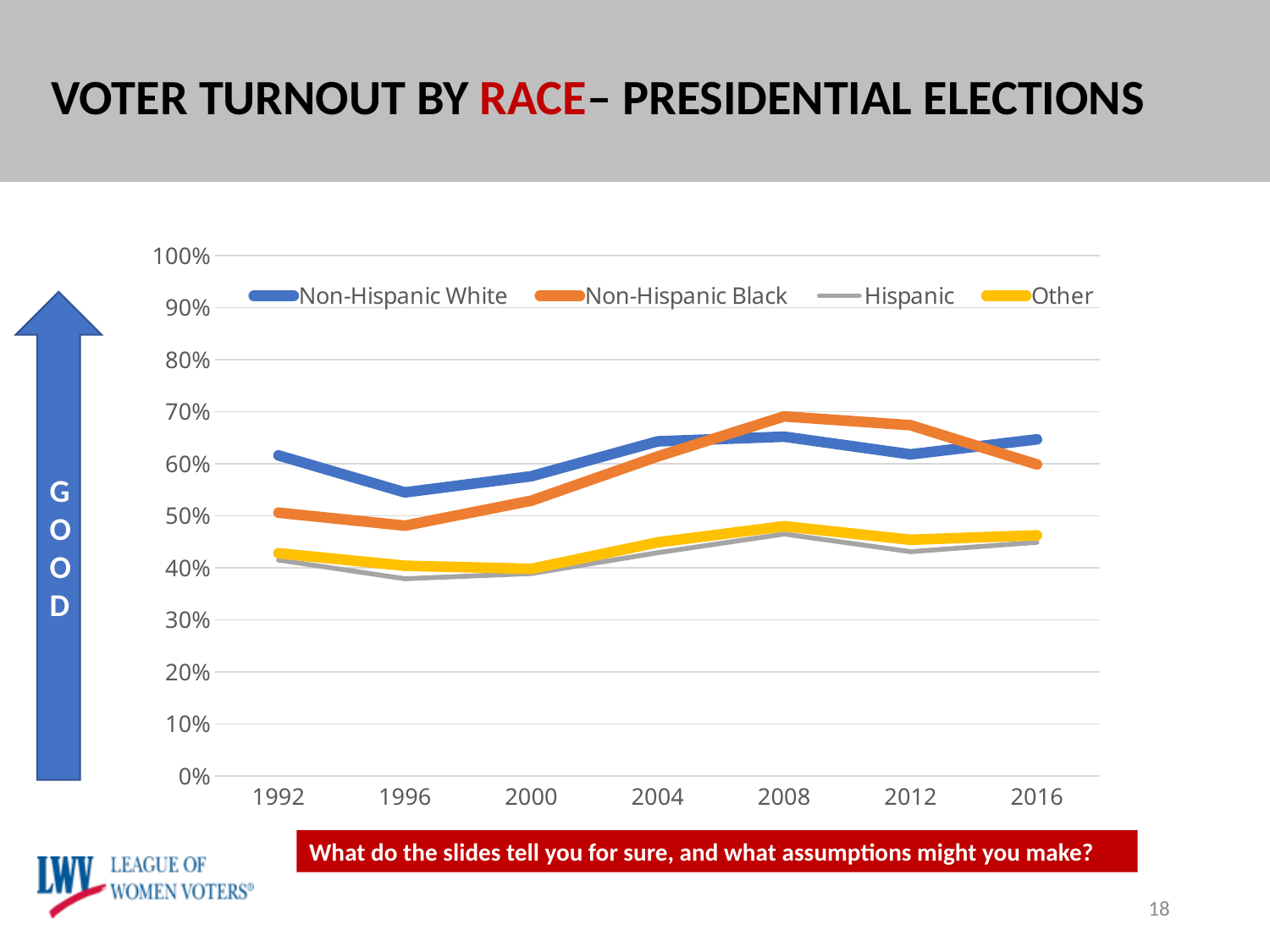
Is the value for Non-Hispanic Black in 2008 greater or less than 60%? greater What is the title of the slide containing the chart? VOTER TURNOUT BY RACE – PRESIDENTIAL ELECTIONS In 2008, which is higher: Non-Hispanic Black or Non-Hispanic White? Non-Hispanic Black How many series does the legend list? 4 How many election years are plotted along the x axis? 7 Which series has the lowest value in 1996? Hispanic Which series has the highest value in 2012? Non-Hispanic Black In 1992, which is higher: Non-Hispanic White or Non-Hispanic Black? Non-Hispanic White Is the value for Non-Hispanic White in 1996 greater or less than 50%? greater What kind of chart is shown on the slide? Line chart Does the Non-Hispanic Black line rise or fall from 2008 to 2016? Fall Is the value for Hispanic in 1996 greater or less than 40%? less